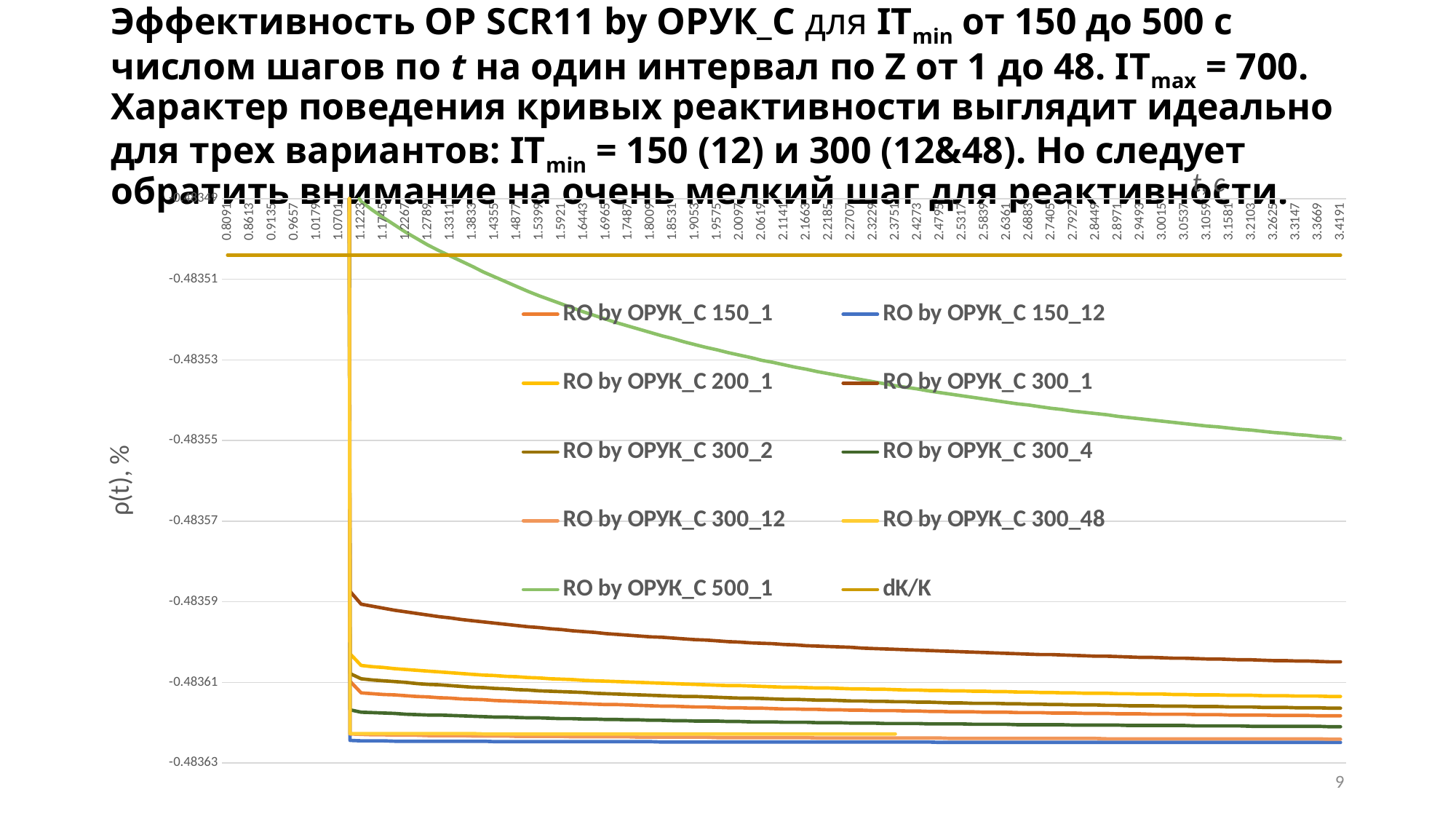
How many series does the legend list? 10 Is the value of RO by ОРУК_С 500_1 at the right end of the chart greater or less than -0.48357? greater Is the value of RO by ОРУК_С 300_1 at the right end of the chart greater or less than -0.48359? less Does the dK/K line rise, fall or stay constant along the x axis? stays constant Which RO by ОРУК_С series has the highest values at the right end of the chart? RO by ОРУК_С 500_1 What kind of chart is shown on the slide? line chart Is the value of the dK/K line greater or less than -0.48351? greater Among RO by ОРУК_С 300_1, 300_2 and 300_4, which series has the lowest values at the right end of the chart? RO by ОРУК_С 300_4 What is the label of the vertical axis? ρ(t), % What colour is the line for the series RO by ОРУК_С 500_1? green Does the RO by ОРУК_С 500_1 curve rise or fall as t increases? falls At the right end of the chart, which is larger: RO by ОРУК_С 300_1 or RO by ОРУК_С 300_2? RO by ОРУК_С 300_1